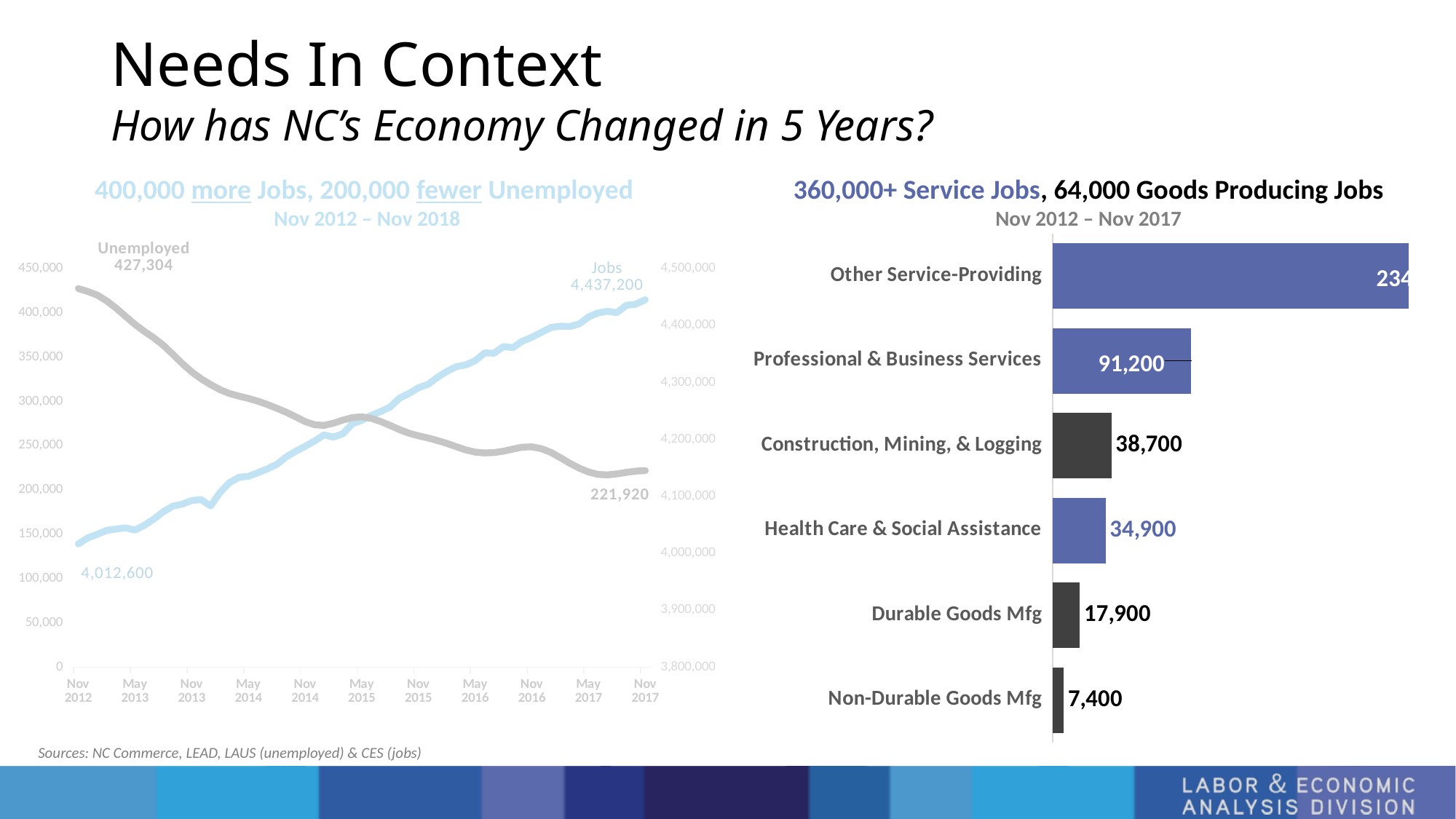
On the right chart, which category has the highest value? Other Service-Providing What kind of chart is the left chart? line chart On the left chart, does the Unemployed line rise or fall from Nov 2012 to Nov 2017? fall On the left chart, what was the Jobs value at the end of the series? 4,437,200 On the right chart, what is the value for Health Care & Social Assistance? 34,900 On the left chart, what was the number of unemployed in Nov 2012? 427,304 On the left chart, what was the number of unemployed at the end of the series? 221,920 On the right chart, what is the value for Professional & Business Services? 91,200 On the right chart, what is the difference between Construction, Mining, & Logging and Health Care & Social Assistance? 3,800 How many categories are shown on the right chart? 6 On the right chart, which category has the lowest value? Non-Durable Goods Mfg On the left chart, what was the Jobs value at the start of the series? 4,012,600